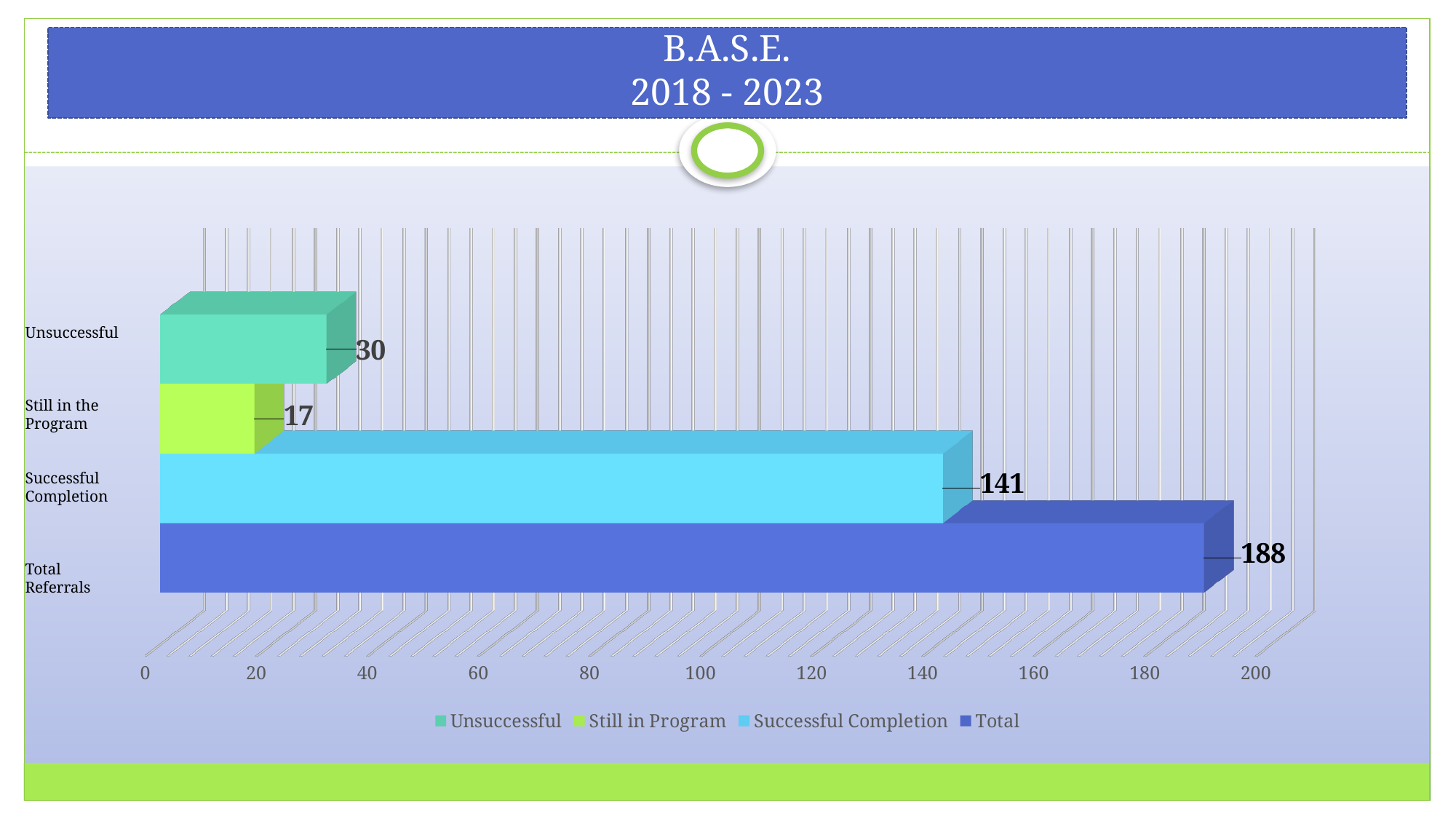
What is the value for Still in the Program? 17 What is the difference between Unsuccessful and Still in the Program? 13 What is the difference between Total Referrals and Successful Completion? 47 What is the value for Successful Completion? 141 How many entries does the legend list? 4 Which is larger, Unsuccessful or Still in the Program? Unsuccessful Which category has the lowest value? Still in the Program What kind of chart is shown on the slide? Bar chart What is the value for Unsuccessful? 30 How many categories are shown in the chart? 4 Which category has the highest value? Total Referrals What is the value for Total Referrals? 188